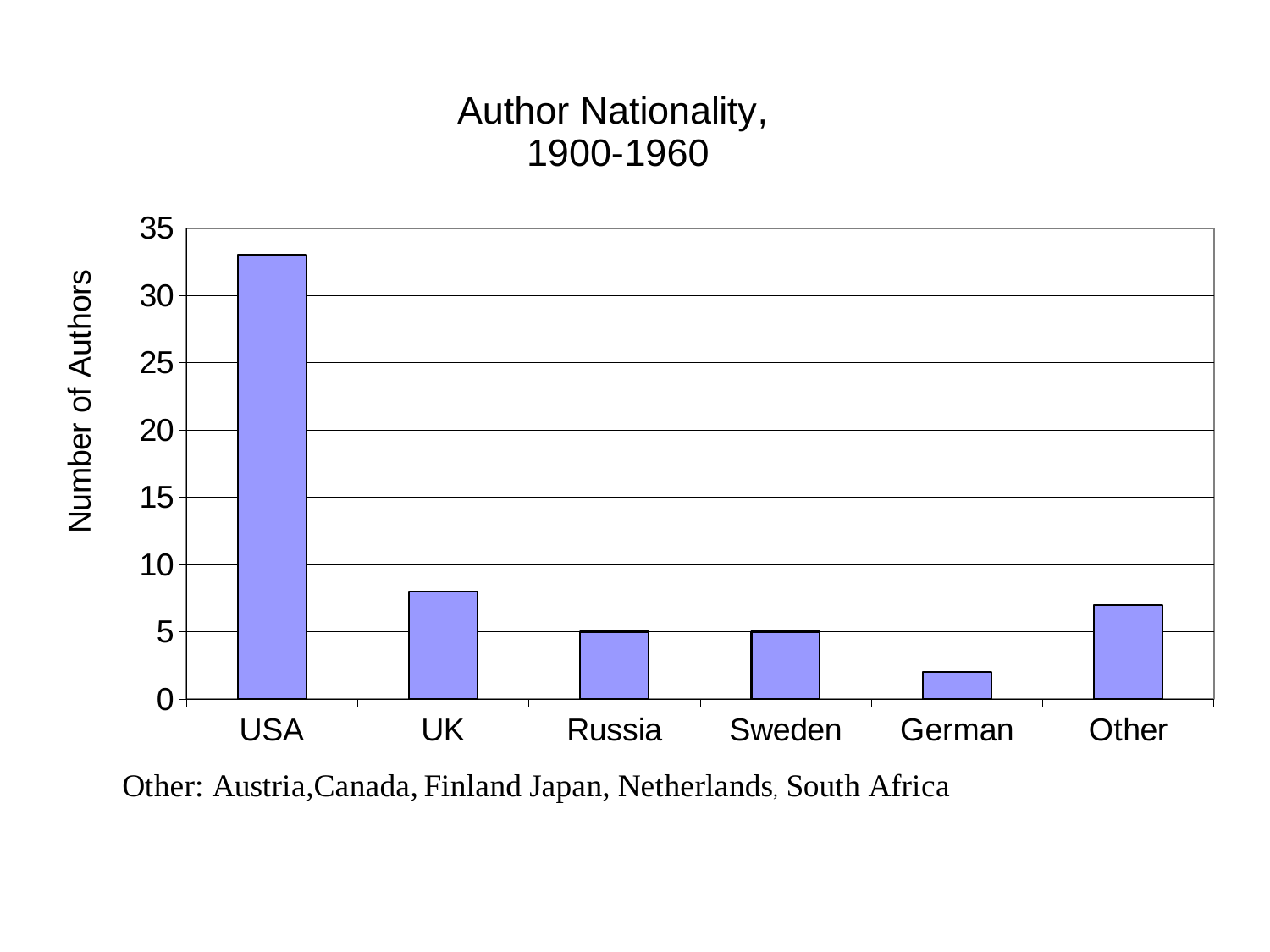
Which nationality has the lowest number of authors? German Is the value for German greater or less than 5? less Is the value for UK greater or less than 10? less What is the label on the y axis? Number of Authors Which nationality has the highest number of authors? USA What kind of chart is shown on the slide? bar chart Which has more authors, UK or Other? UK Is the value for USA greater or less than 30? greater How many nationality categories are shown on the x axis? 6 What is the title of the chart? Author Nationality, 1900-1960 What is the number of authors for Sweden? 5 What is the number of authors for Russia? 5